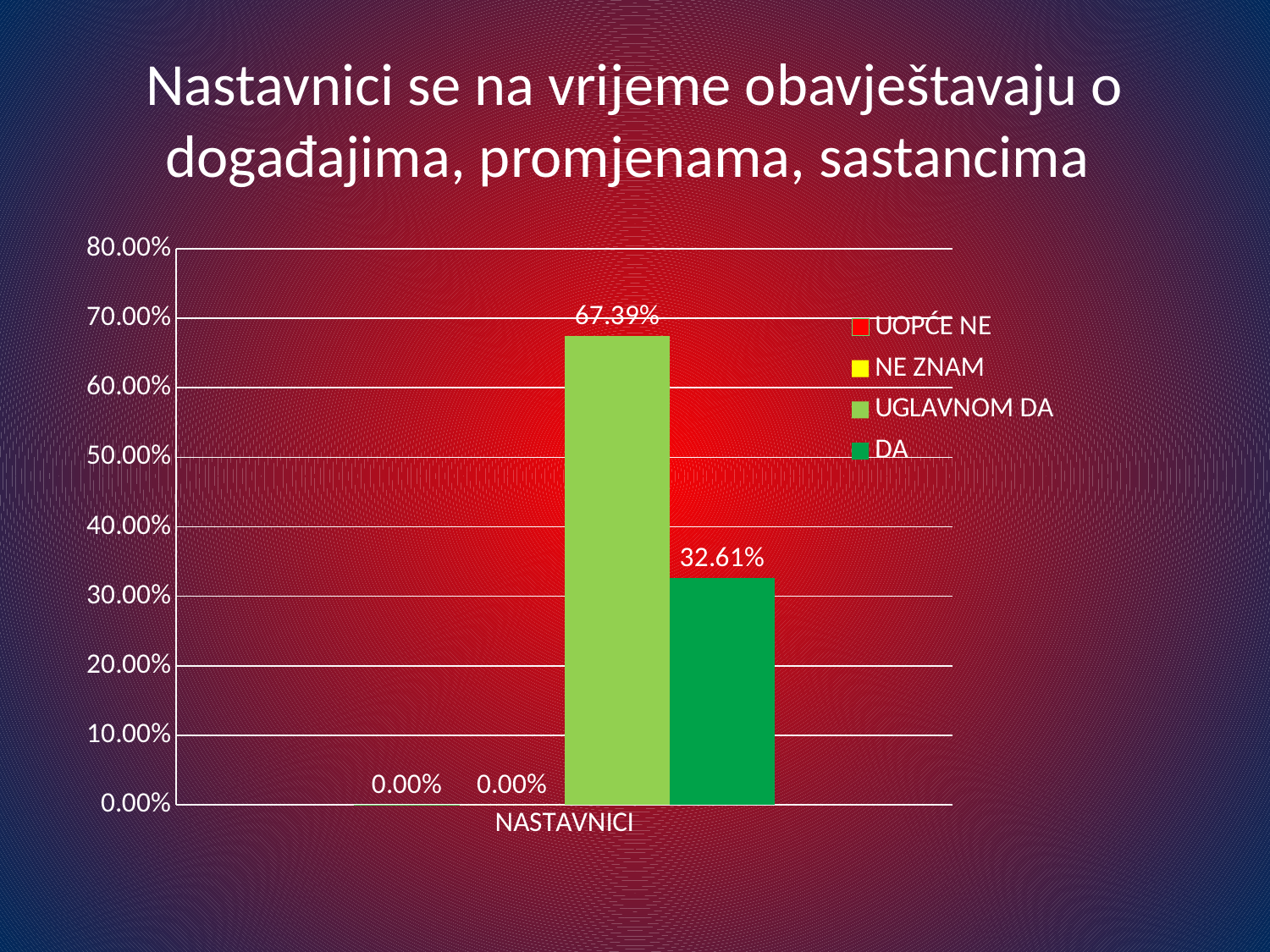
Is the value for DA greater or less than 40.00%? less What is the difference between the values for UGLAVNOM DA and DA? 34.78% How many series does the legend list? 4 What is the value for UGLAVNOM DA? 67.39% What colour is the bar for DA? dark green What kind of chart is shown? bar chart Which series has the highest value? UGLAVNOM DA Which is larger, the value for DA or the value for UGLAVNOM DA? UGLAVNOM DA What is the value for UOPĆE NE? 0.00% What is the value for NE ZNAM? 0.00% What is the value for DA? 32.61% What is the category label on the x axis? NASTAVNICI